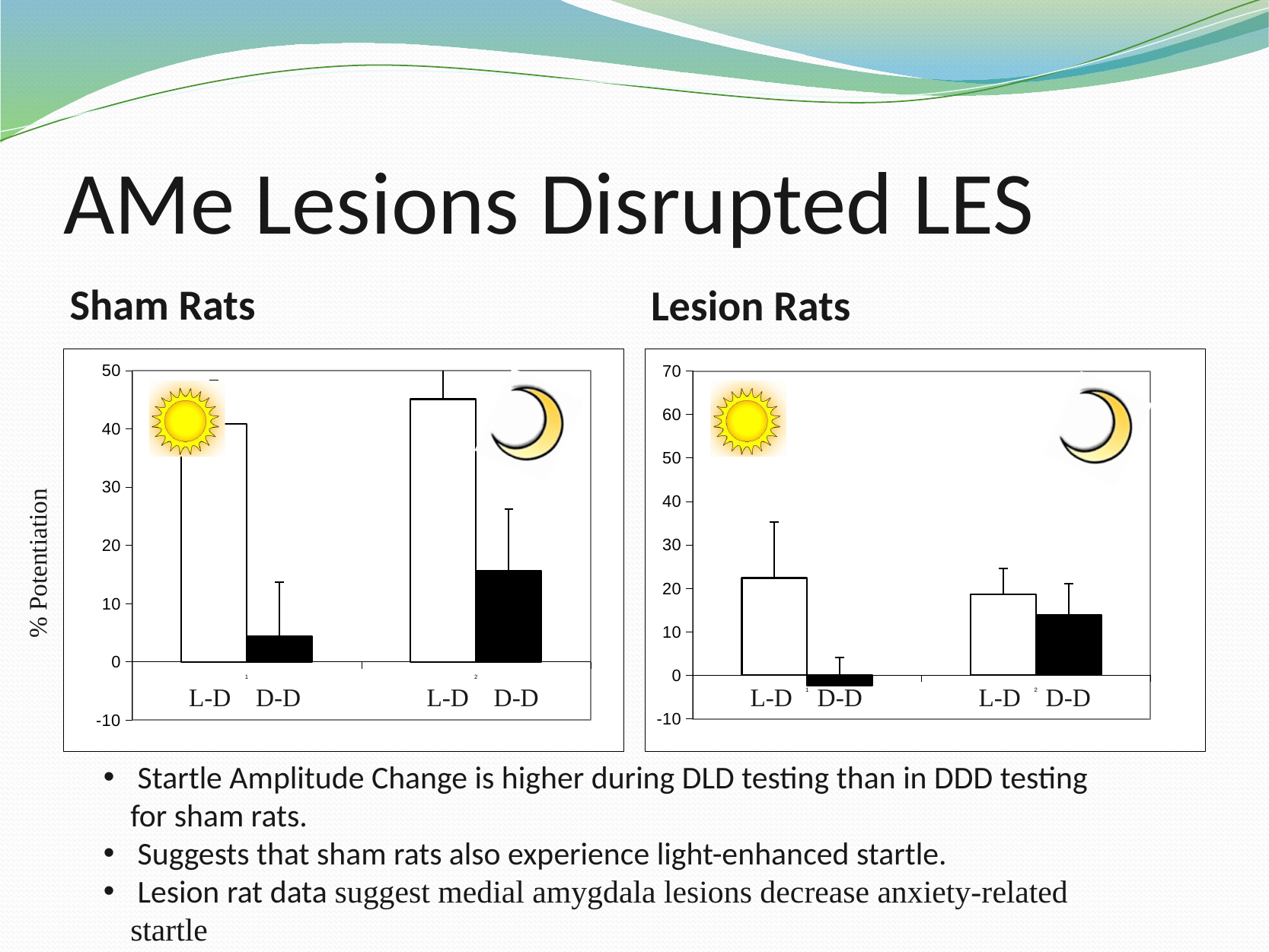
In the Lesion Rats chart, which bar is the lowest? D-D under the sun In the Sham Rats chart, is the value of the second L-D bar (under the moon) greater or less than 40? greater In the Lesion Rats chart, is the value of the first L-D bar (under the sun) greater or less than 30? less How many bars are plotted in the Lesion Rats chart? 4 In the Lesion Rats chart, is the value of the first D-D bar (under the sun) greater or less than 0? less What type of chart is shown for Sham Rats? bar chart In the Sham Rats chart, which bar is the shortest? D-D under the sun In the Sham Rats chart, which bar is the tallest? L-D under the moon In the Lesion Rats chart, which is larger: the second L-D bar (under the moon) or the second D-D bar (under the moon)? L-D What is the y-axis label shown beside the Sham Rats chart? % Potentiation